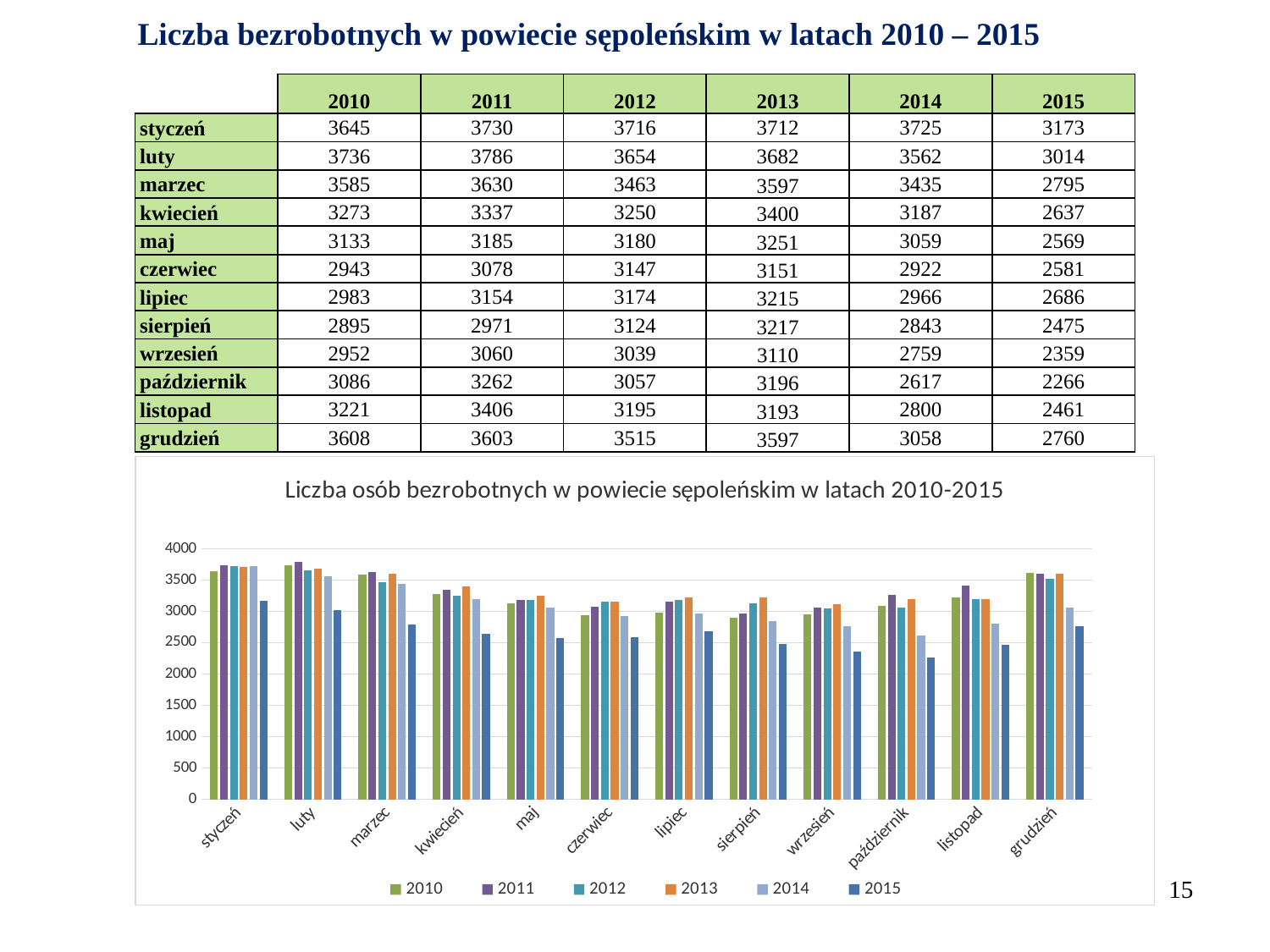
What kind of chart is shown on the slide? bar chart How many series does the chart legend list? 6 What is the difference between the styczeń values for 2010 and 2015? 472 Which month has the highest value in the 2015 series? styczeń How many month categories are shown on the x axis of the chart? 12 Is the value for październik in 2015 greater or less than 2500? less What is the title of the chart? Liczba osób bezrobotnych w powiecie sępoleńskim w latach 2010-2015 Which month has the lowest value in the 2015 series? październik In the 2015 series, do the values rise or fall from styczeń to maj? fall What is the number of unemployed for styczeń in 2015? 3173 What is the value for sierpień in 2013? 3217 For luty, which year has the larger value, 2011 or 2014? 2011